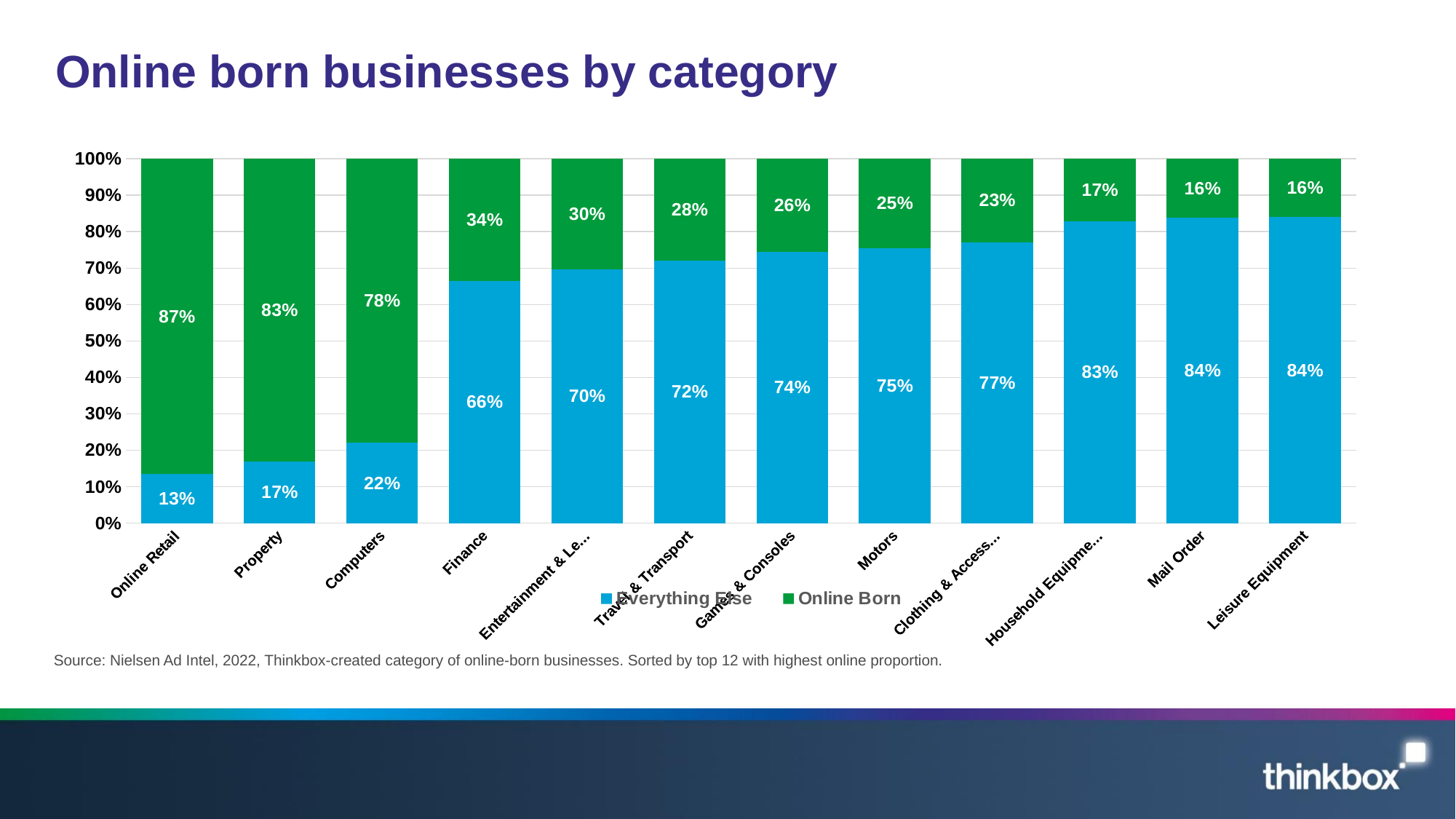
Which category has the lowest Everything Else share? Online Retail What is the Everything Else share for Finance? 66% How many series does the legend list? 2 What colour represents the Online Born series? Green Which has the larger Online Born share, Motors or Travel & Transport? Travel & Transport How many categories are shown on the x axis? 12 What is the Online Born share for Online Retail? 87% Does the Online Born share rise or fall moving from left to right along the x axis? Fall Is the Everything Else value for Mail Order greater or less than 80%? greater What kind of chart is shown on the slide? Stacked bar chart Which category has the highest Online Born share? Online Retail What is the difference between the Online Born share for Property and for Computers? 5 percentage points